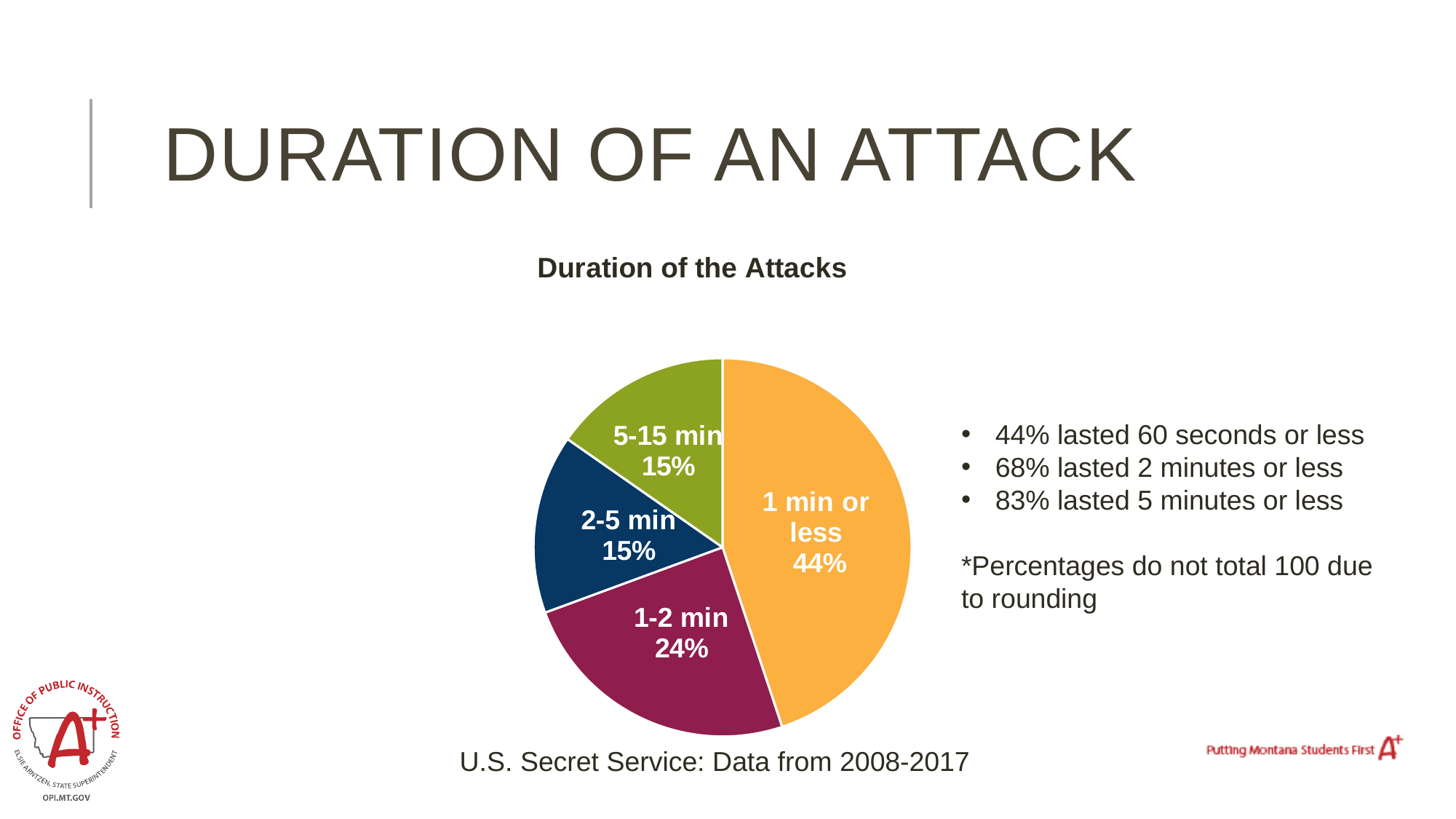
What percentage of attacks lasted 5-15 min? 15% What is the difference in percentage points between the 1 min or less slice and the 1-2 min slice? 20 What type of chart is shown on the slide? pie chart Which is larger, the share for 1-2 min or the share for 2-5 min? 1-2 min What percentage of attacks lasted 1-2 min? 24% How many slices does the pie chart have? 4 What is the combined percentage of the 1 min or less and 1-2 min slices? 68% What colour is the slice for 1 min or less? orange Which duration category has the largest share of the pie? 1 min or less What is the title of the chart? Duration of the Attacks What percentage of attacks lasted 1 min or less? 44% What percentage of attacks lasted 2-5 min? 15%